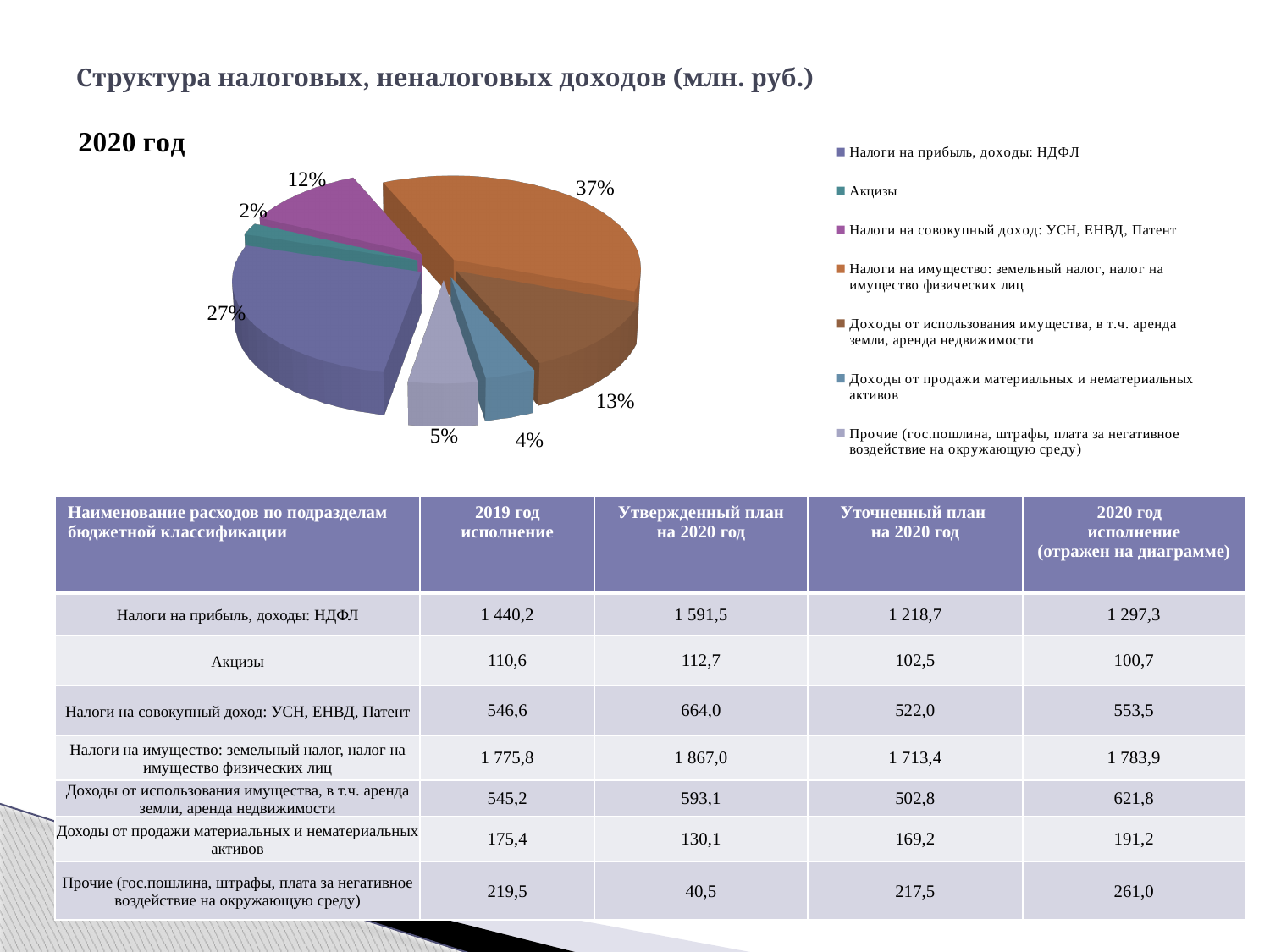
What share of the pie does "Налоги на имущество: земельный налог, налог на имущество физических лиц" have? 37% What kind of chart is shown on the slide? Pie chart What share of the pie does "Налоги на прибыль, доходы: НДФЛ" have? 27% Which category has the largest slice of the pie chart? Налоги на имущество: земельный налог, налог на имущество физических лиц Which slice is larger: "Прочие (гос.пошлина, штрафы, плата за негативное воздействие на окружающую среду)" or "Доходы от продажи материальных и нематериальных активов"? Прочие (гос.пошлина, штрафы, плата за негативное воздействие на окружающую среду) How many entries does the legend of the pie chart list? 7 Which category has the smallest slice of the pie chart? Акцизы What share of the pie does "Налоги на совокупный доход: УСН, ЕНВД, Патент" have? 12% How many slices does the pie chart have? 7 What is the difference in percentage points between the largest slice (37%) and the "Налоги на прибыль, доходы: НДФЛ" slice (27%)? 10 percentage points